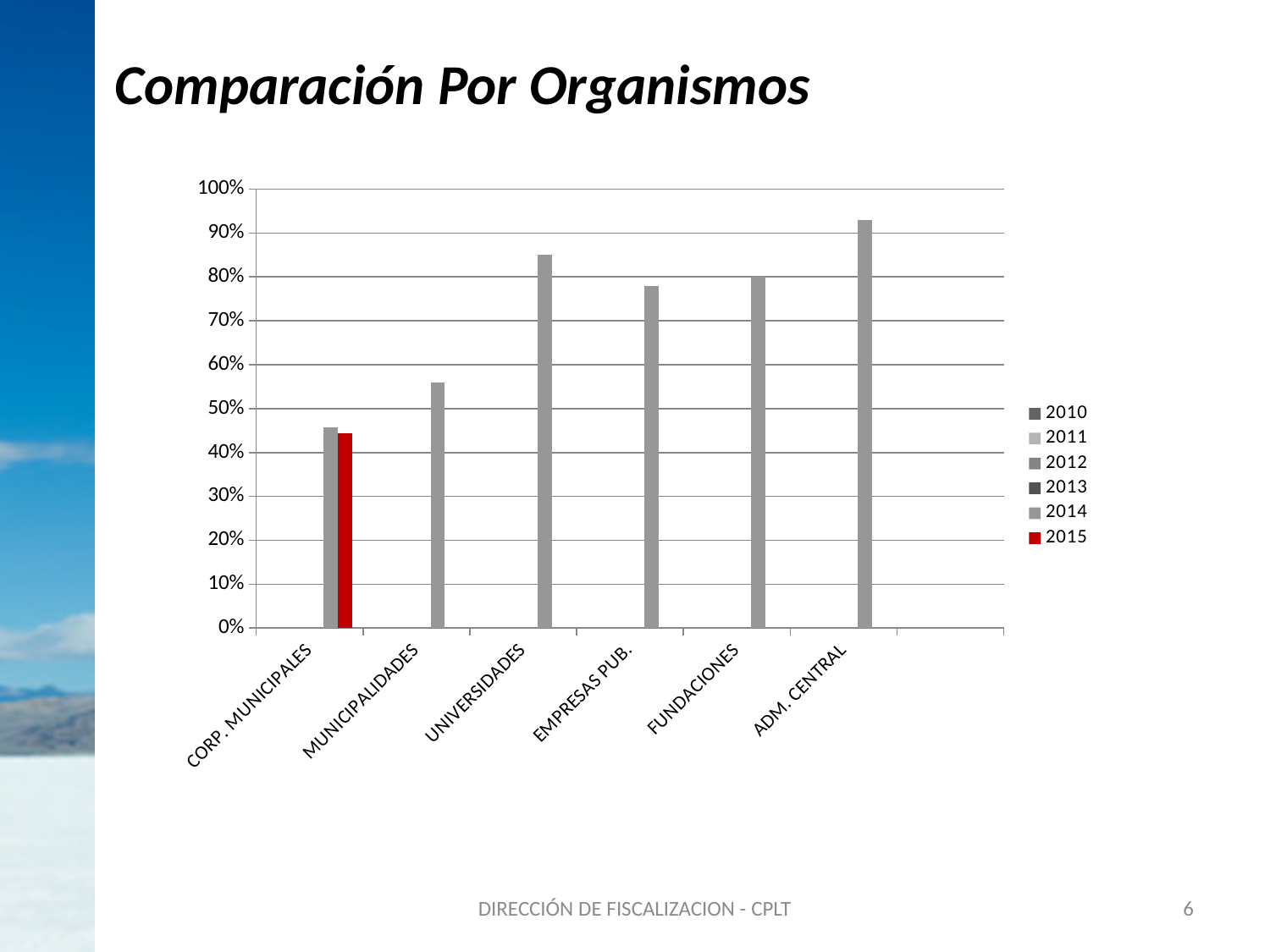
What is the title of the slide containing the chart? Comparación Por Organismos Is the 2014 value for EMPRESAS PUB. greater or less than 70%? greater Is the 2014 value for UNIVERSIDADES greater or less than 80%? greater Which category has the lowest bars in the chart? CORP. MUNICIPALES How many categories are shown on the x axis of the chart? 6 Is the 2015 value for CORP. MUNICIPALES greater or less than 50%? less What kind of chart is shown on the slide? bar chart Which category has the highest bar in the chart? ADM. CENTRAL How many series does the chart's legend list? 6 Which is larger, the 2014 value for ADM. CENTRAL or the 2014 value for FUNDACIONES? ADM. CENTRAL Which is larger, the 2014 value for UNIVERSIDADES or the 2014 value for MUNICIPALIDADES? UNIVERSIDADES